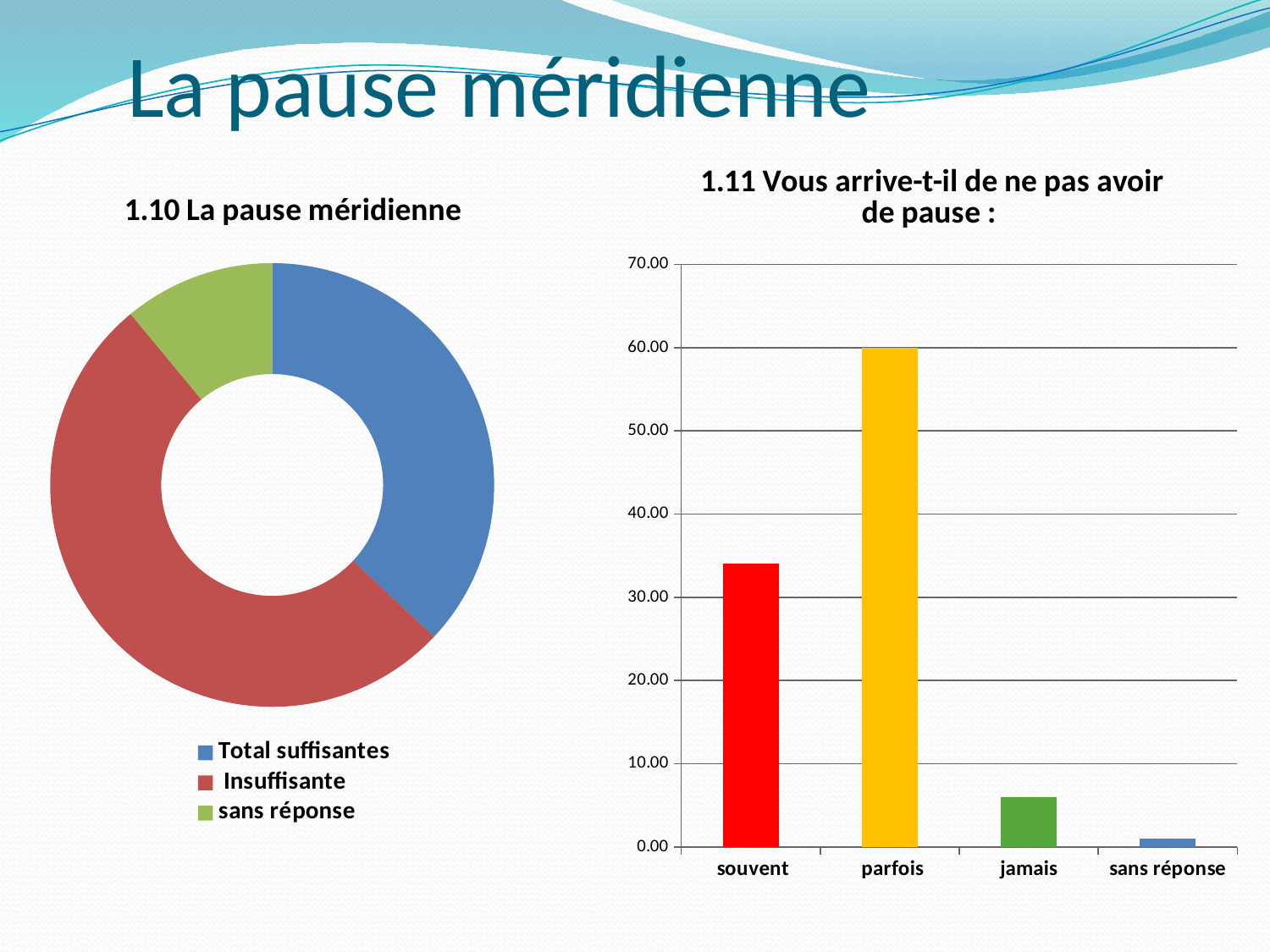
In the chart titled '1.10 La pause méridienne', how many entries does the legend list? 3 In the chart titled '1.10 La pause méridienne', which slice is the largest? Insuffisante In the chart titled '1.11 Vous arrive-t-il de ne pas avoir de pause :', how many categories are shown on the x axis? 4 In the chart titled '1.11 Vous arrive-t-il de ne pas avoir de pause :', is the value for 'souvent' greater or less than 30.00? greater In the chart titled '1.11 Vous arrive-t-il de ne pas avoir de pause :', which category has the lowest value? sans réponse In the chart titled '1.11 Vous arrive-t-il de ne pas avoir de pause :', is the value for 'jamais' greater or less than 10.00? less In the chart titled '1.10 La pause méridienne', which slice is the smallest? sans réponse In the chart titled '1.11 Vous arrive-t-il de ne pas avoir de pause :', what kind of chart is shown? bar chart In the chart titled '1.10 La pause méridienne', what kind of chart is shown? doughnut chart In the chart titled '1.11 Vous arrive-t-il de ne pas avoir de pause :', which category has the highest value? parfois In the chart titled '1.11 Vous arrive-t-il de ne pas avoir de pause :', which is larger, the value for 'souvent' or the value for 'jamais'? souvent In the chart titled '1.11 Vous arrive-t-il de ne pas avoir de pause :', what is the value for 'parfois'? 60.00